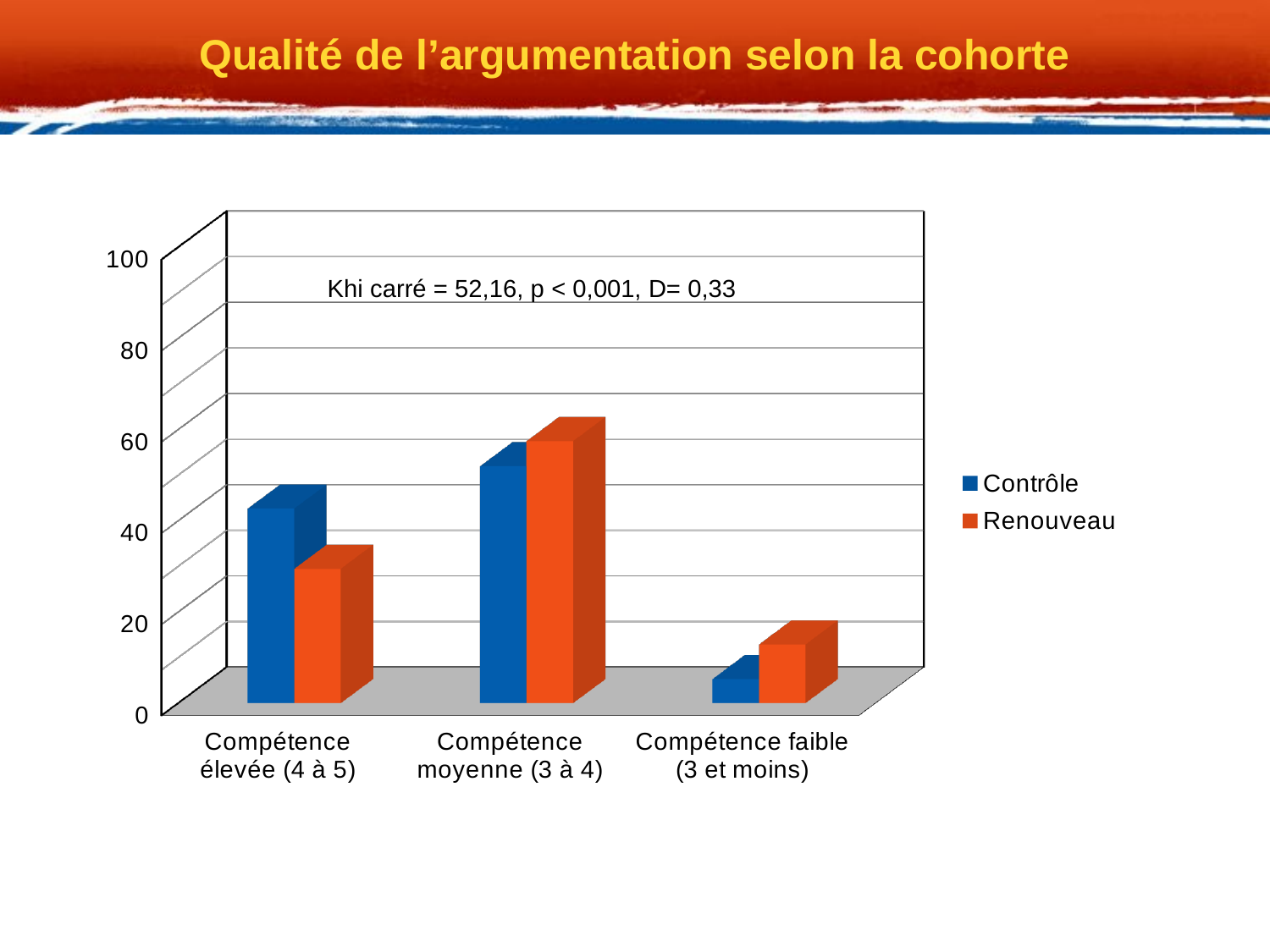
Which category has the highest bar for the Renouveau series? Compétence moyenne (3 à 4) Which series is shown in orange? Renouveau Is the value for Renouveau in Compétence élevée (4 à 5) greater or less than 40? less For Compétence faible (3 et moins), which series has the larger value, Contrôle or Renouveau? Renouveau For Compétence élevée (4 à 5), which series has the larger value, Contrôle or Renouveau? Contrôle How many categories are shown on the x axis? 3 Is the value for Contrôle in Compétence élevée (4 à 5) greater or less than 40? greater What is the title of the slide? Qualité de l'argumentation selon la cohorte Which category has the lowest bar for the Contrôle series? Compétence faible (3 et moins) How many series does the legend list? 2 Is the value for Renouveau in Compétence faible (3 et moins) greater or less than 20? less What kind of chart is shown on the slide? bar chart